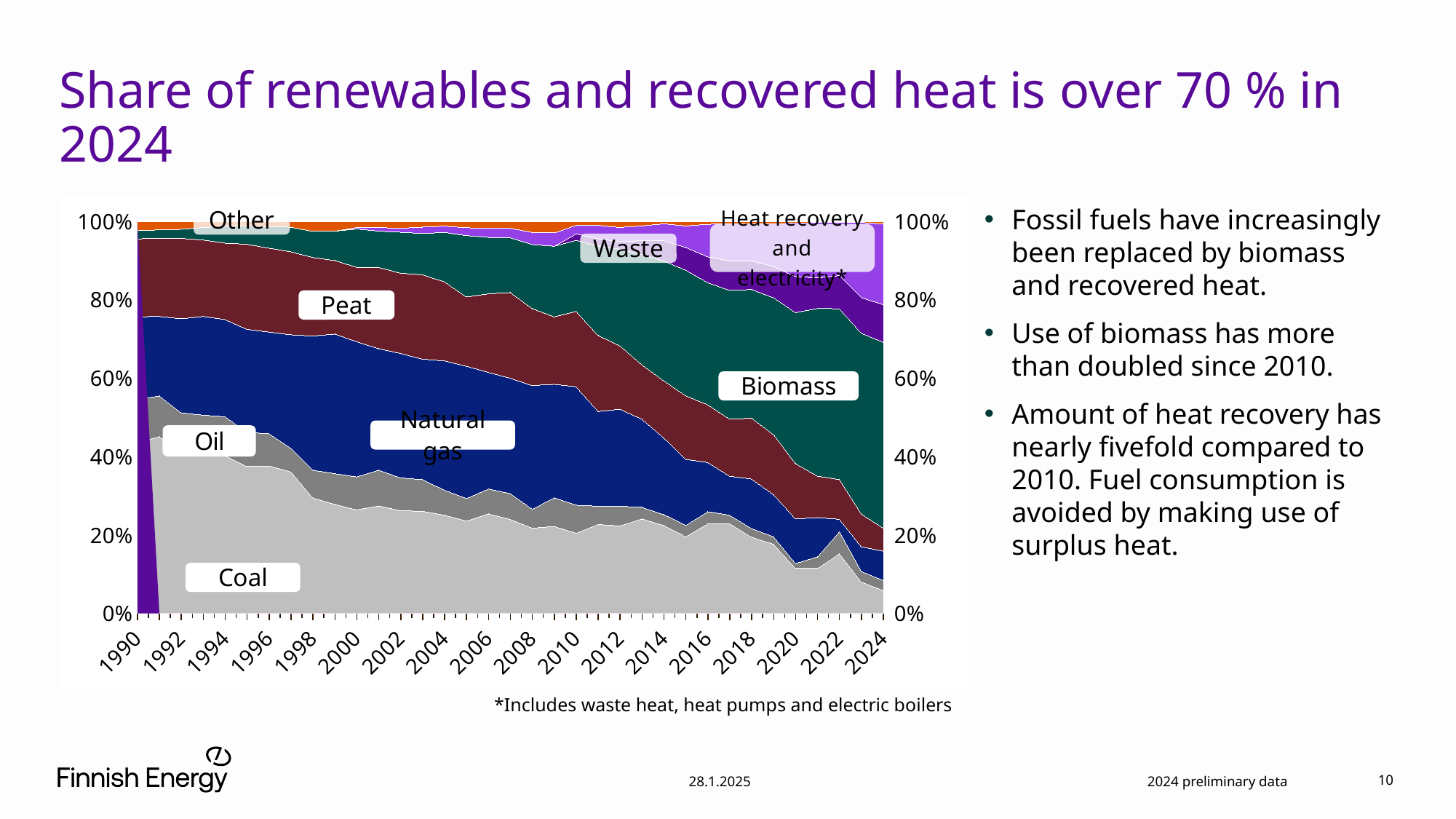
Which series has the largest share in 1992? Coal What is the last year shown on the x axis of the chart? 2024 Is the share of coal larger in 1992 or in 2024? 1992 What kind of chart is shown on the slide? Stacked area chart Which series is plotted at the bottom of the stacked area chart? Coal Does the share of biomass rise or fall from 2010 to 2024? Rise What is the first year shown on the x axis of the chart? 1990 How many fuel/heat source series are labelled in the chart? 8 Is the share of coal in 2024 greater or less than 20%? less Which series has the largest share in 2024? Biomass Does the share of coal rise or fall from 1992 to 2024? Fall